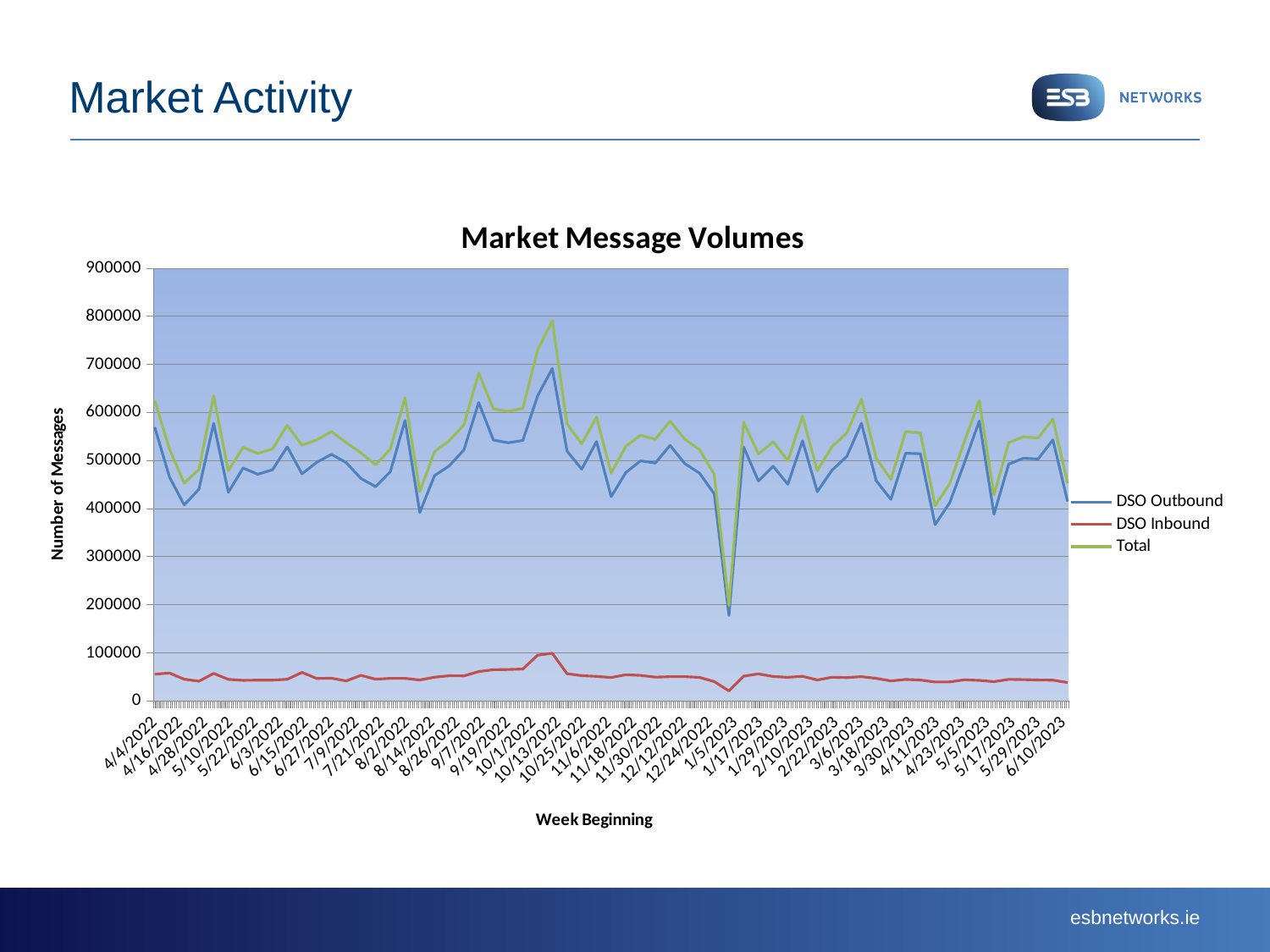
Is the value of DSO Outbound at 4/4/2022 greater or less than 500000? greater What is the highest value shown on the vertical axis of the chart? 900000 Which series in the chart has the lowest values throughout the period? DSO Inbound Which is larger at 10/13/2022: the Total series or the DSO Inbound series? Total Is the DSO Inbound series ever greater than 200000, or always less? less Is the peak value of the Total series, around 10/13/2022, greater or less than 700000? greater What kind of chart is shown on the slide? Line chart What is the title of the chart? Market Message Volumes Which series in the chart has the highest values throughout the period? Total What is the label of the vertical axis of the chart? Number of Messages How many series does the legend of the Market Message Volumes chart list? 3